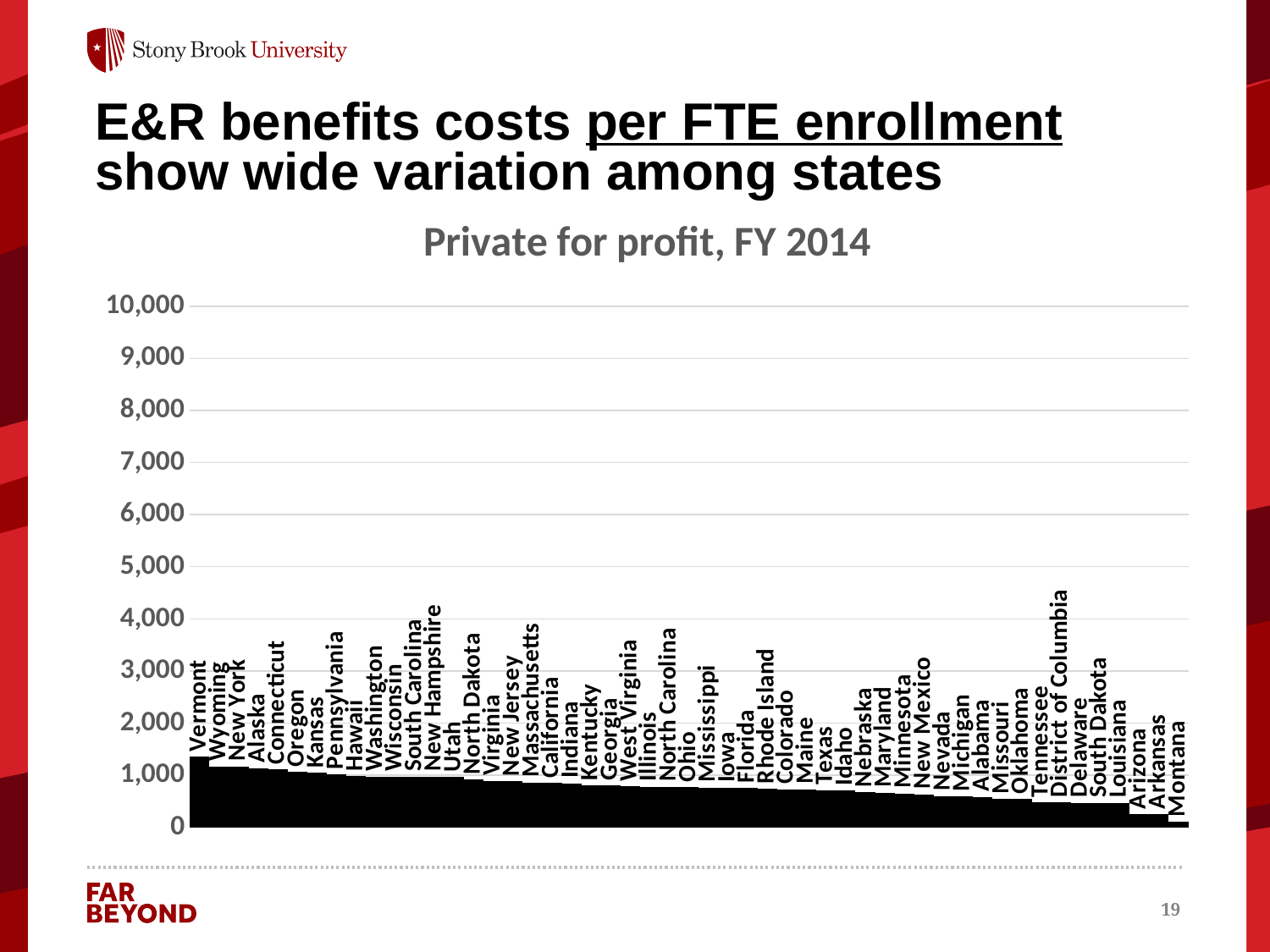
Is the value for Montana greater or less than 1,000? less Do the values rise or fall moving from left to right along the x axis? fall Which has a larger value, Vermont or Montana? Vermont What kind of chart is shown on the slide? bar chart Which state has the lowest E&R benefits cost per FTE enrollment in the chart? Montana How many categories (states and districts) are plotted in the chart? 51 Is the value for Vermont greater or less than 1,000? greater What is the highest value shown on the y axis? 10,000 Which state has the highest E&R benefits cost per FTE enrollment in the chart? Vermont What is the title of the chart? Private for profit, FY 2014 Which has a larger value, Wyoming or Arkansas? Wyoming Is the value for Vermont greater or less than 2,000? less